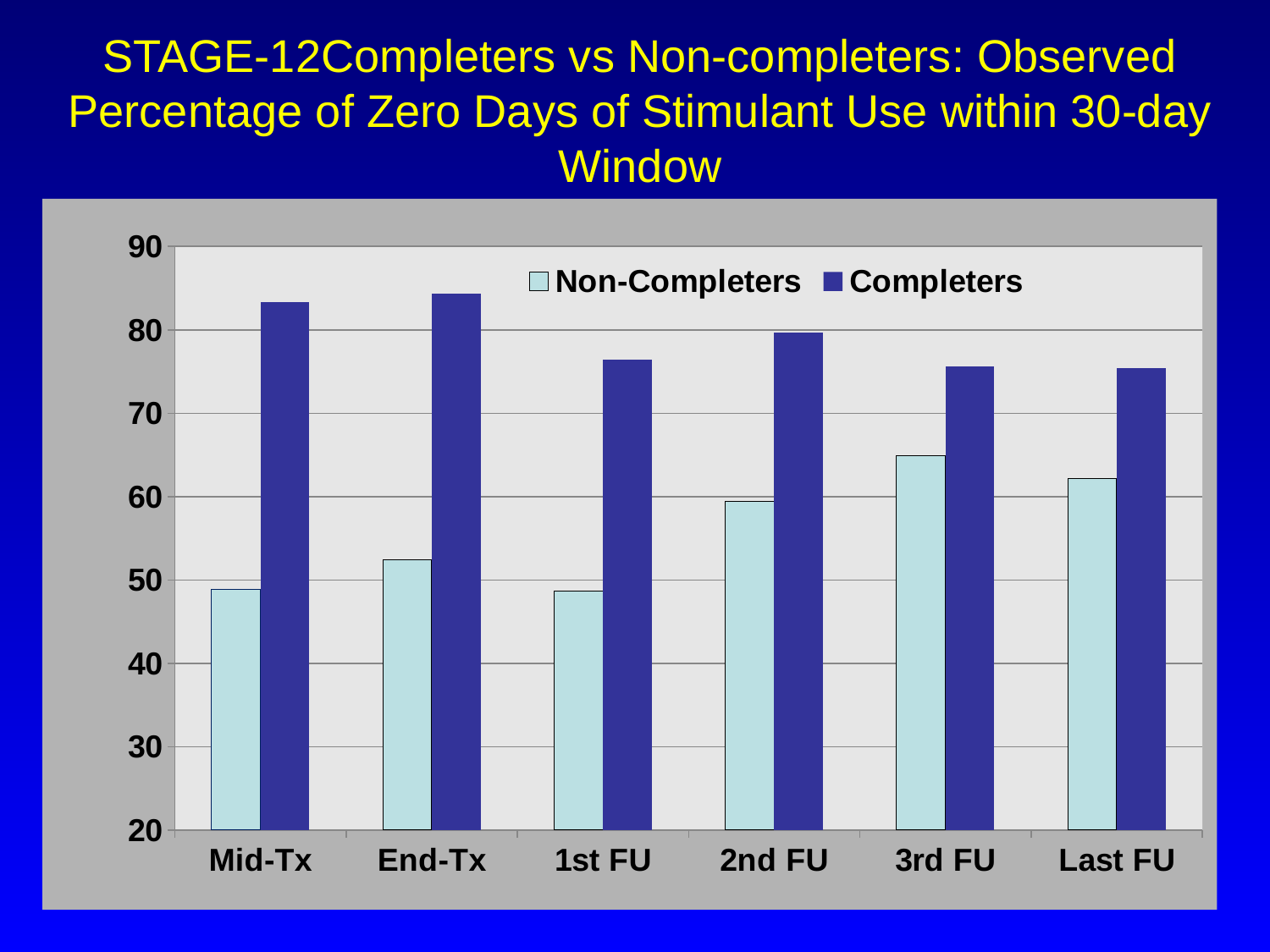
Is the Completers value for Last FU greater or less than 70? greater How many categories are shown on the x axis? 6 At 2nd FU, which series has the larger value, Completers or Non-Completers? Completers Is the Completers value for 1st FU greater or less than 80? less Is the Non-Completers value for 3rd FU greater or less than 60? greater What kind of chart is shown on the slide? bar chart Which series is shown in dark blue in the legend? Completers For Non-Completers, is the value at Last FU higher or lower than at Mid-Tx? higher How many series does the legend list? 2 Which category has the highest Non-Completers value? 3rd FU